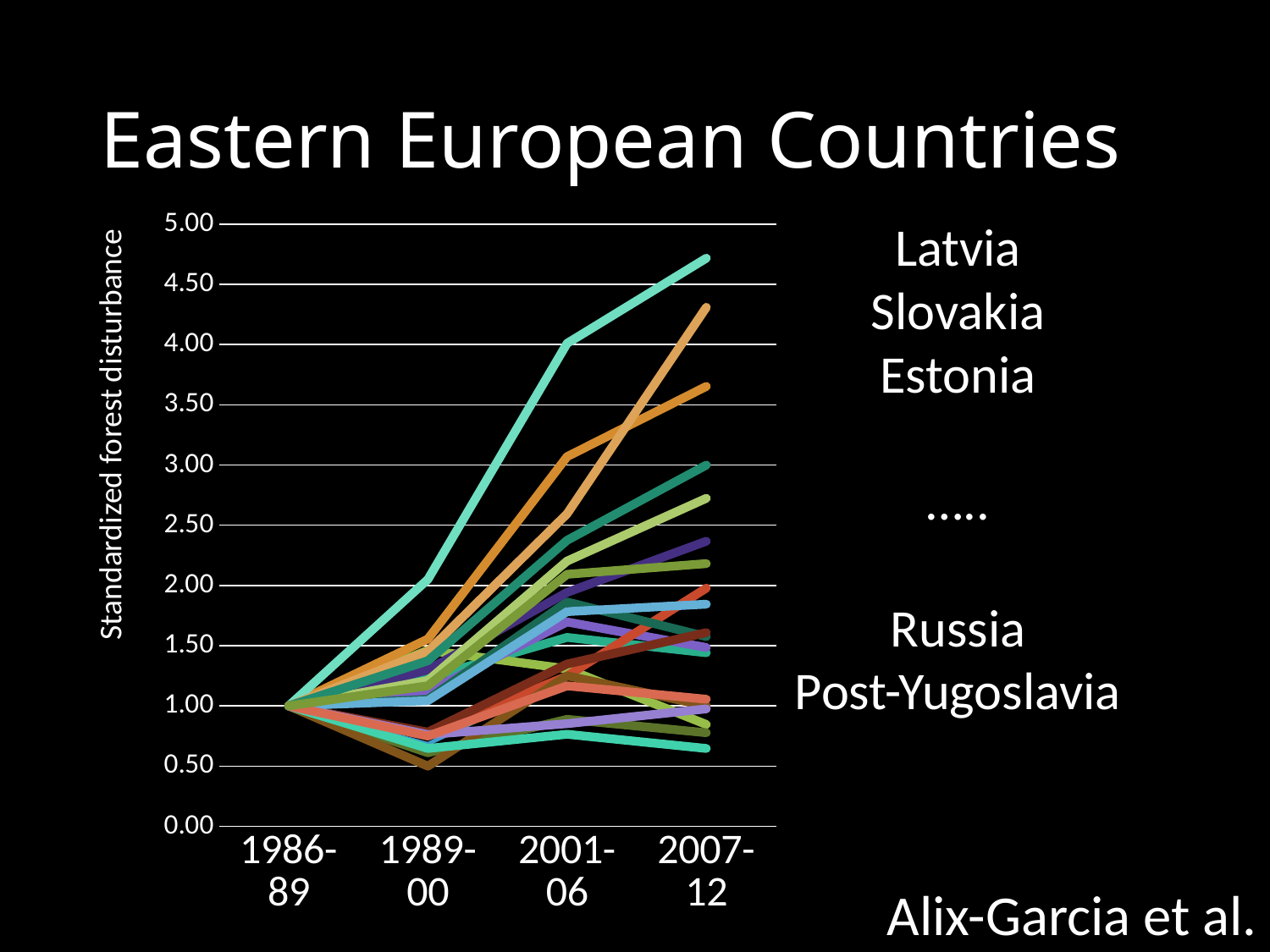
What kind of chart is shown on the slide? line chart What value do all the lines share in the 1986-89 period? 1.00 In which period does the lowest plotted value on the chart occur? 1989-00 Is the lowest value plotted in the 2007-12 period greater or less than 1.00? less Does the topmost line rise or fall from 1986-89 to 2007-12? rise In which period does the topmost line reach its highest value? 2007-12 What is the title of the chart? Eastern European Countries What is the label of the y axis? Standardized forest disturbance How many time periods are shown along the x axis? 4 Is the highest value plotted in the 1989-00 period greater or less than 1.50? greater Is the highest value plotted in the 2007-12 period greater or less than 4.50? greater What is the maximum value shown on the y axis? 5.00